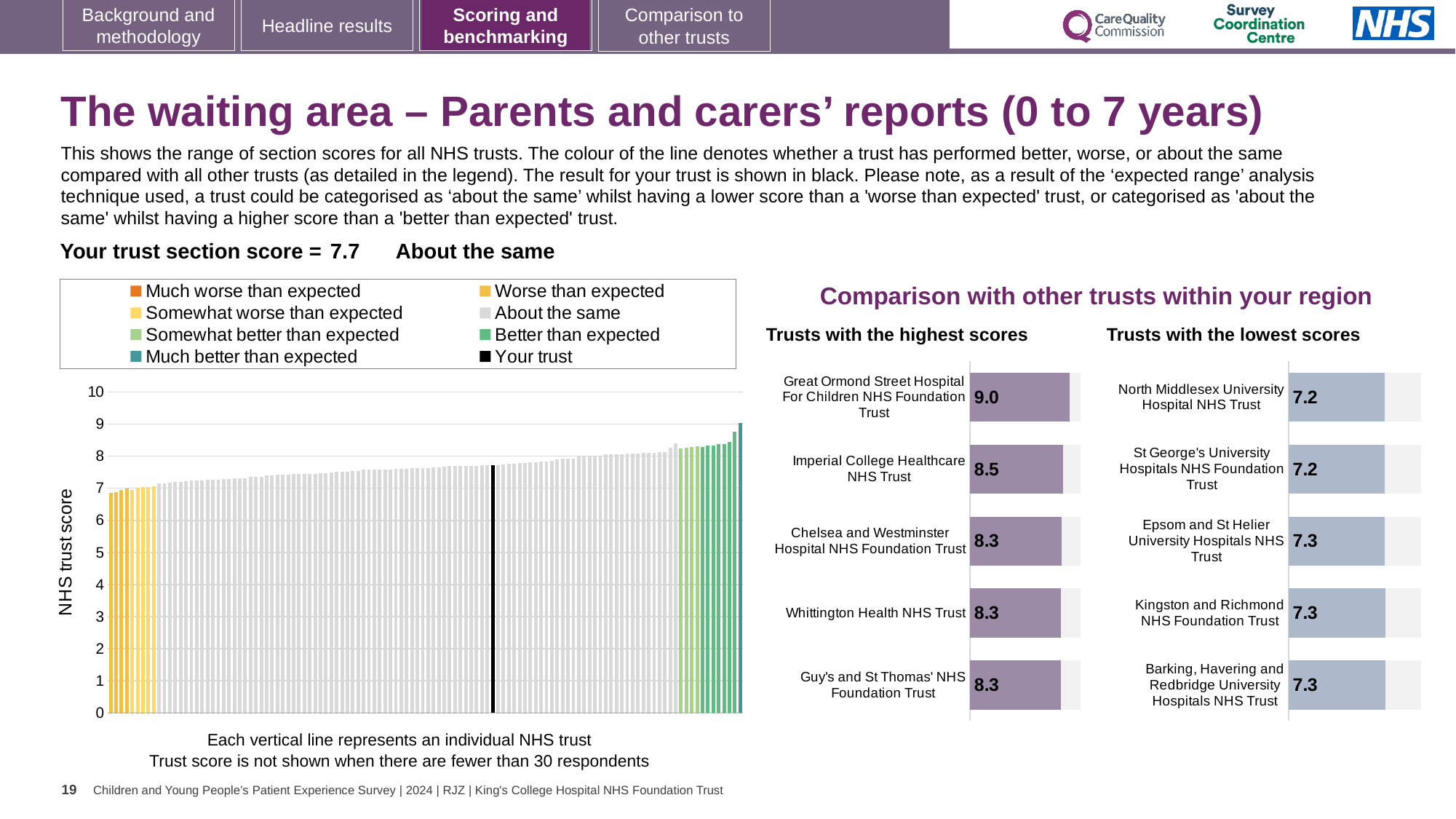
In the 'Trusts with the highest scores' chart, which has the larger score: Great Ormond Street Hospital For Children NHS Foundation Trust or Whittington Health NHS Trust? Great Ormond Street Hospital For Children NHS Foundation Trust In the 'NHS trust score' chart on the left, do the bar heights rise or fall from left to right? Rise In the 'Trusts with the highest scores' chart, which trust has the highest score? Great Ormond Street Hospital For Children NHS Foundation Trust How many trusts are listed in the 'Trusts with the lowest scores' chart? 5 In the 'Trusts with the highest scores' chart, what is the difference between the scores of Great Ormond Street Hospital For Children NHS Foundation Trust and Imperial College Healthcare NHS Trust? 0.5 In the 'Trusts with the lowest scores' chart, what is the score for Barking, Havering and Redbridge University Hospitals NHS Trust? 7.3 In the 'NHS trust score' chart on the left, is the value of the black 'Your trust' bar greater or less than 7? greater In the 'Trusts with the highest scores' chart, what is the score for Imperial College Healthcare NHS Trust? 8.5 In the 'Trusts with the lowest scores' chart, what is the score for North Middlesex University Hospital NHS Trust? 7.2 What kind of chart is the 'NHS trust score' chart on the left of the slide? Bar chart In the 'Trusts with the highest scores' chart, what is the score for Great Ormond Street Hospital For Children NHS Foundation Trust? 9.0 How many entries does the legend of the 'NHS trust score' chart on the left list? 8